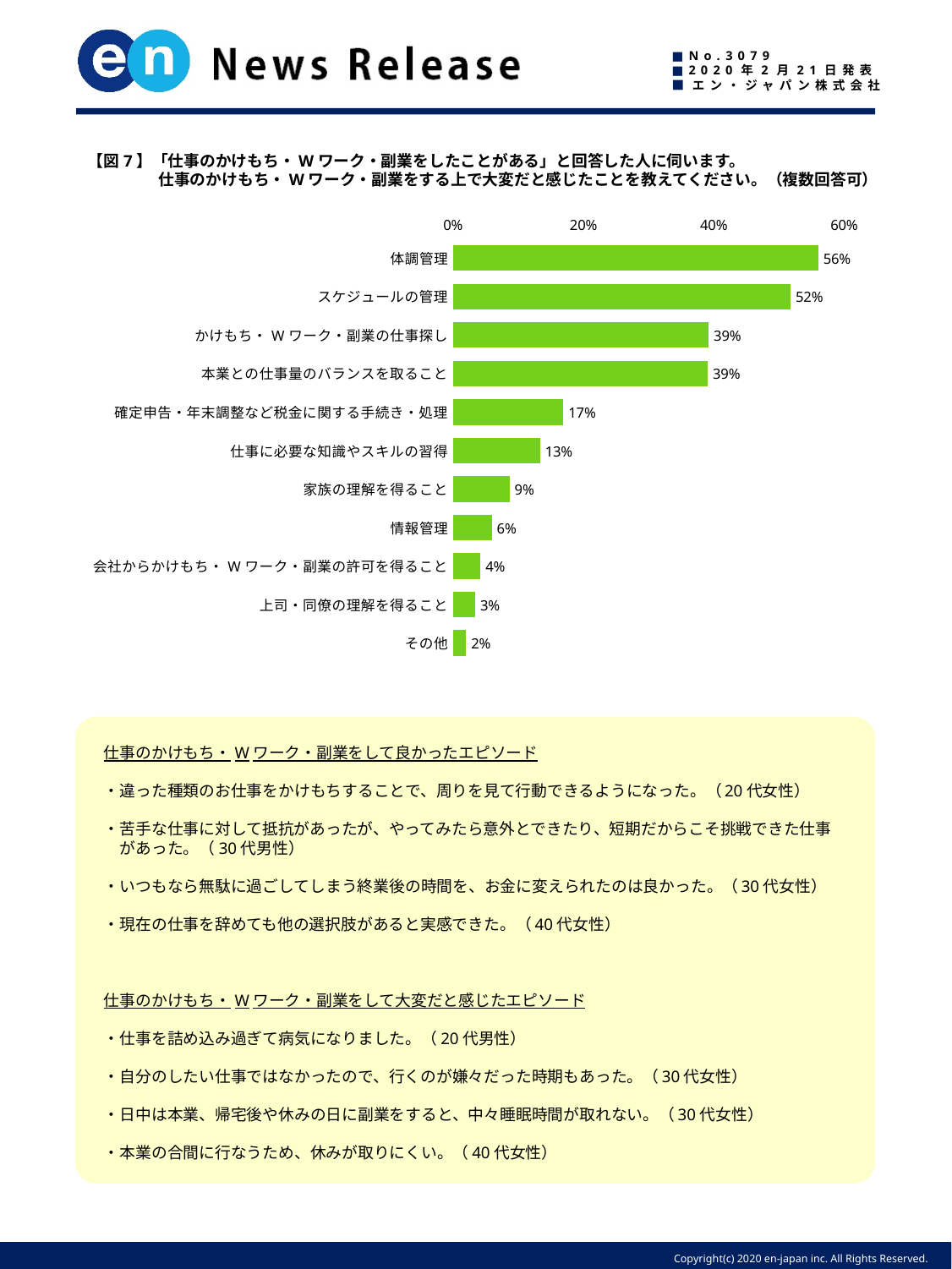
What is the difference between the values for 本業との仕事量のバランスを取ること and 仕事に必要な知識やスキルの習得? 26% Which category has the lowest value? その他 What is the value for 体調管理? 56% What is the value for 家族の理解を得ること? 9% Is the value for スケジュールの管理 greater or less than 40%? greater What is the value for 確定申告・年末調整など税金に関する手続き・処理? 17% What kind of chart is shown on the slide? bar chart What colour are the bars in the chart? green Which category has the highest value? 体調管理 How many categories are shown in the chart? 11 What is the difference between the values for 体調管理 and スケジュールの管理? 4% Which is larger, the value for 情報管理 or the value for 上司・同僚の理解を得ること? 情報管理